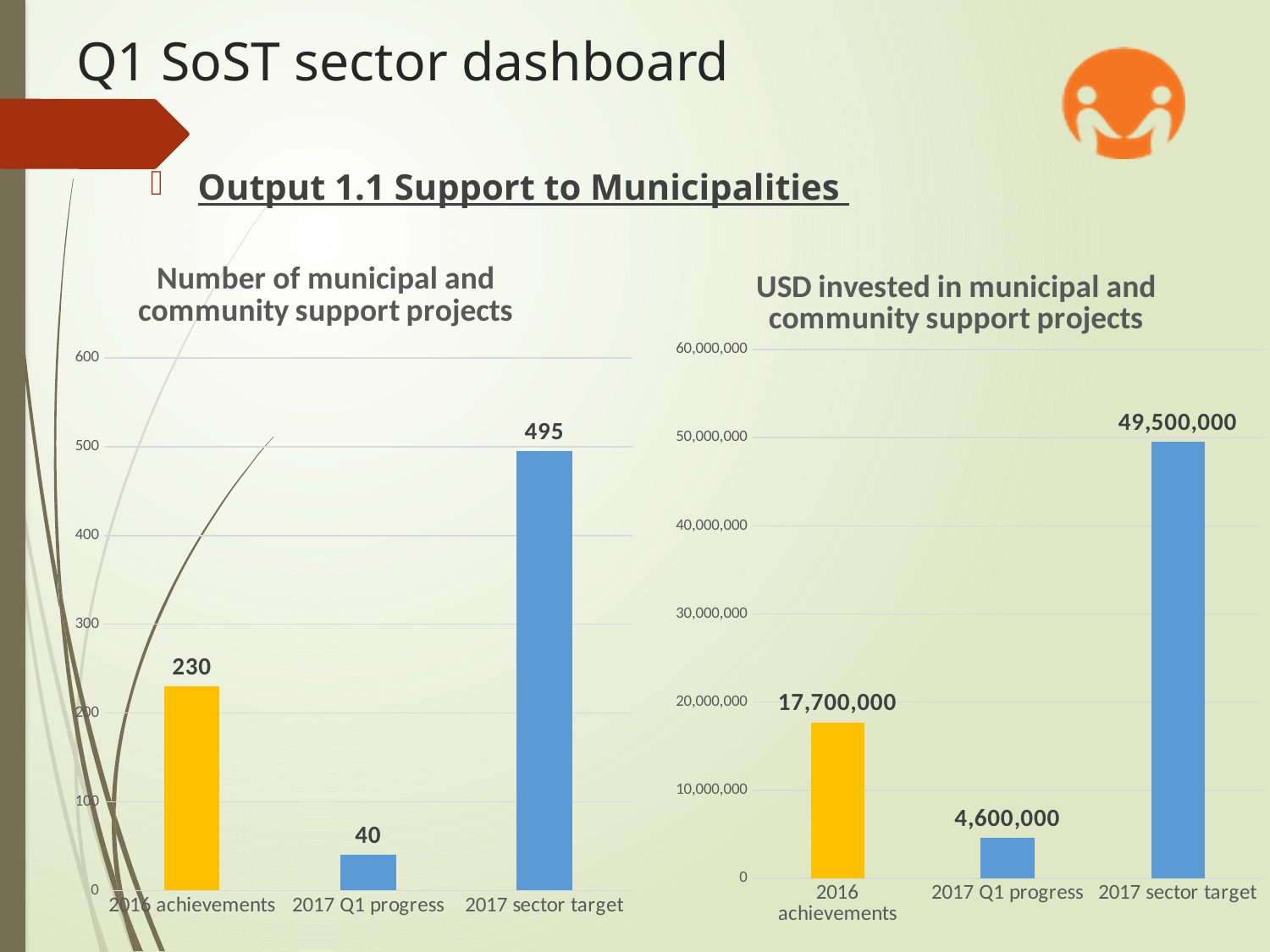
In the 'USD invested in municipal and community support projects' chart, what is the difference between the 2017 sector target and the 2017 Q1 progress? 44,900,000 In the 'Number of municipal and community support projects' chart, what is the difference between the 2017 sector target and the 2016 achievements? 265 In the 'Number of municipal and community support projects' chart, what is the value for 2017 sector target? 495 In the 'USD invested in municipal and community support projects' chart, what is the value for 2017 Q1 progress? 4,600,000 In the 'USD invested in municipal and community support projects' chart, what is the value for 2016 achievements? 17,700,000 In the 'Number of municipal and community support projects' chart, what is the value for 2017 Q1 progress? 40 What kind of chart is the 'USD invested in municipal and community support projects' chart? Bar chart How many categories are shown in the 'Number of municipal and community support projects' chart? 3 In the 'USD invested in municipal and community support projects' chart, which category has the highest value? 2017 sector target In the 'USD invested in municipal and community support projects' chart, which is larger: 2016 achievements or 2017 Q1 progress? 2016 achievements In the 'Number of municipal and community support projects' chart, what is the value for 2016 achievements? 230 In the 'Number of municipal and community support projects' chart, which category has the lowest value? 2017 Q1 progress